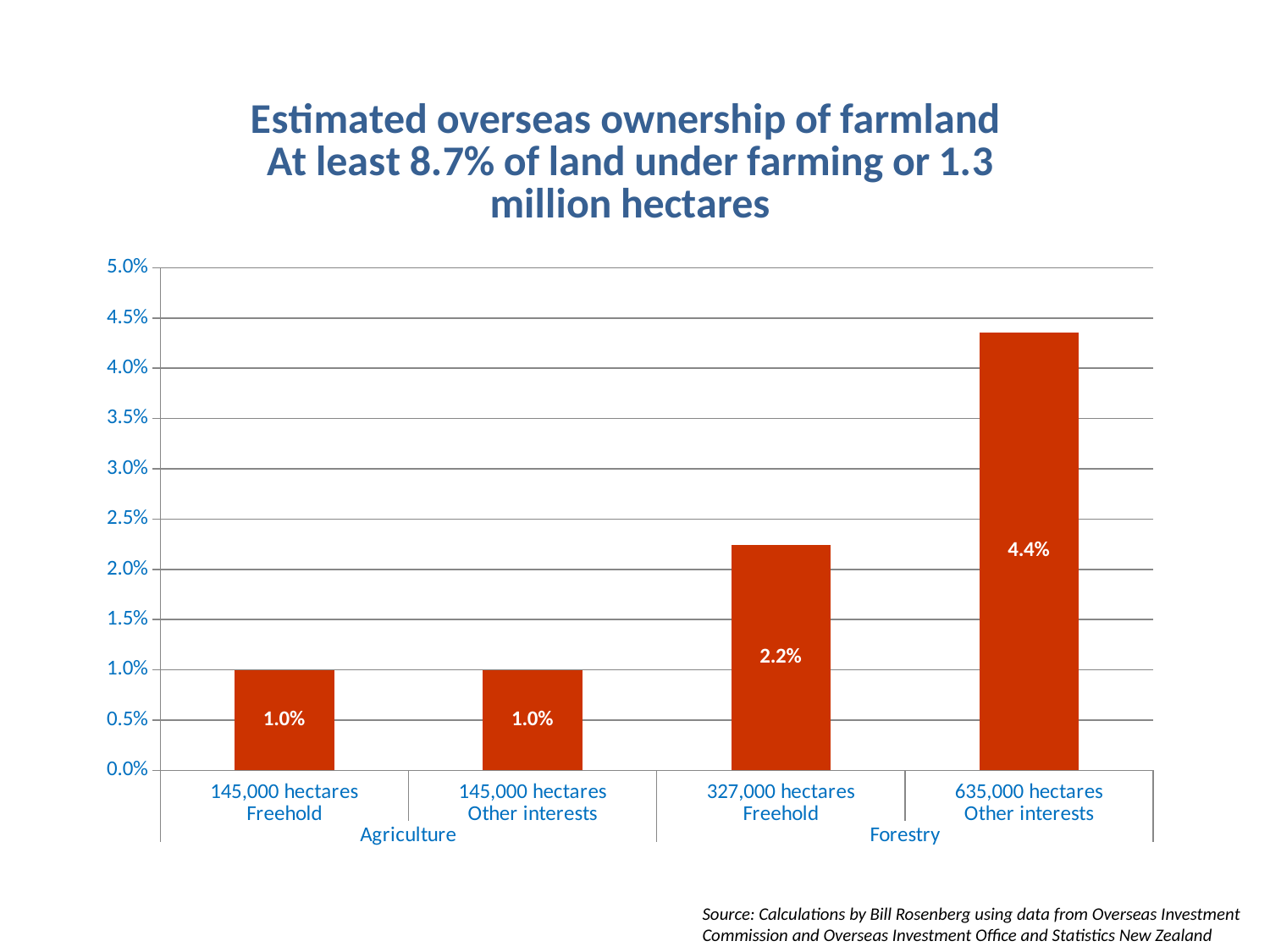
What is the value for Forestry Other interests (635,000 hectares)? 4.4% How many bars are plotted in the chart? 4 What is the value for Forestry Freehold (327,000 hectares)? 2.2% What is the title of the chart? Estimated overseas ownership of farmland At least 8.7% of land under farming or 1.3 million hectares What is the value for Agriculture Freehold (145,000 hectares)? 1.0% What is the difference between the Forestry Other interests value and the Forestry Freehold value? 2.2% What is the difference between the Forestry Freehold value and the Agriculture Freehold value? 1.2% Which is larger, the value for Forestry Freehold or the value for Agriculture Other interests? Forestry Freehold What is the maximum value shown on the vertical axis? 5.0% Is the value for Forestry Other interests greater or less than 4.0%? greater Which category has the highest value? Forestry Other interests (635,000 hectares) What kind of chart is shown on the slide? Bar chart